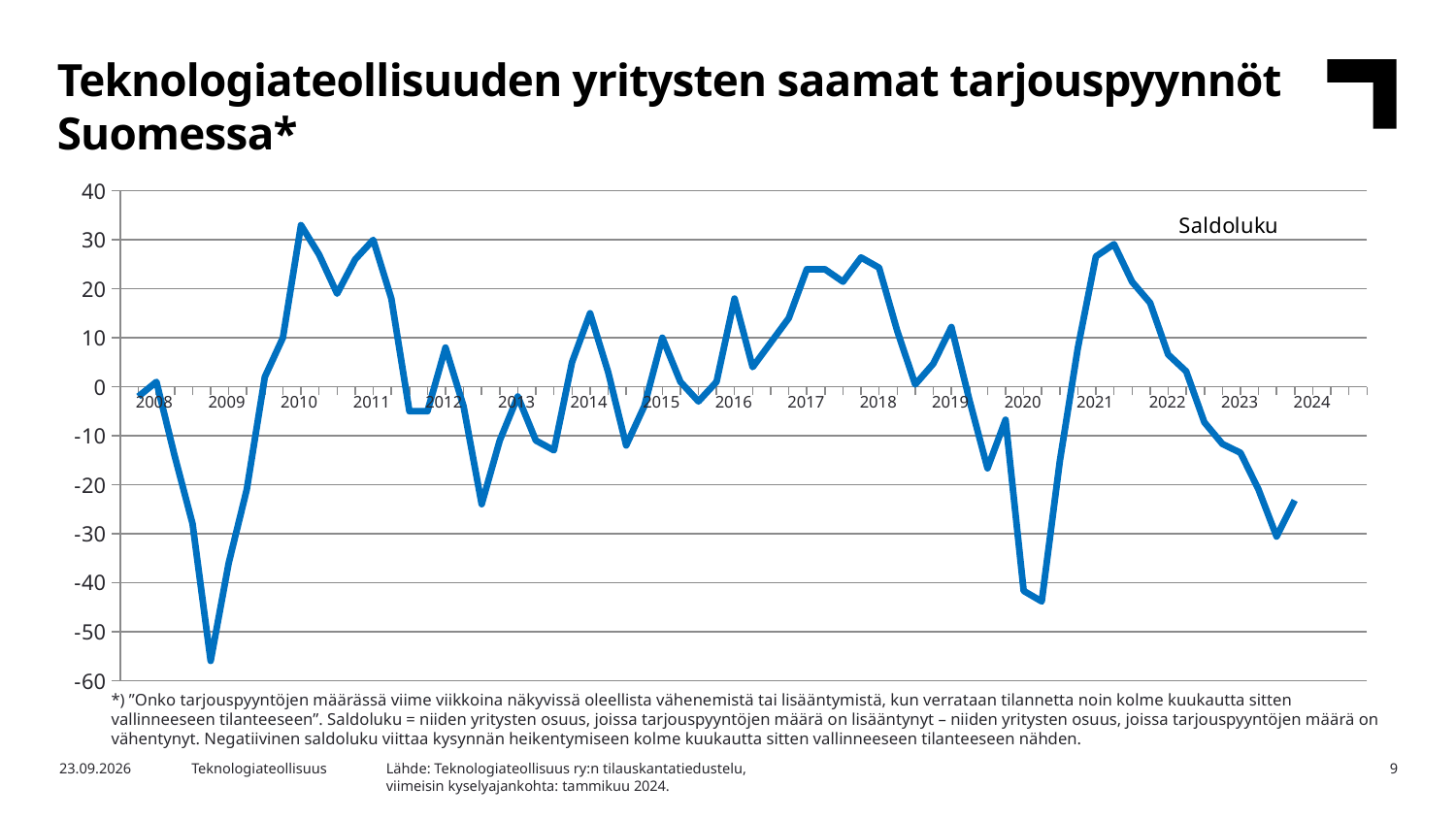
What is the title of the slide containing the chart? Teknologiateollisuuden yritysten saamat tarjouspyynnöt Suomessa* Is the peak value of the line in 2021 greater or less than 20? greater What kind of chart is shown on the slide? line chart Is the peak value of the line in 2010 greater or less than 30? greater Is the lowest value of the line in 2009 greater or less than -50? less Which year contains the lowest point of the whole line? 2009 Which dip is lower: the one in 2009 or the one in 2020? 2009 Does the line rise or fall from its 2021 peak to the end of 2023? fall